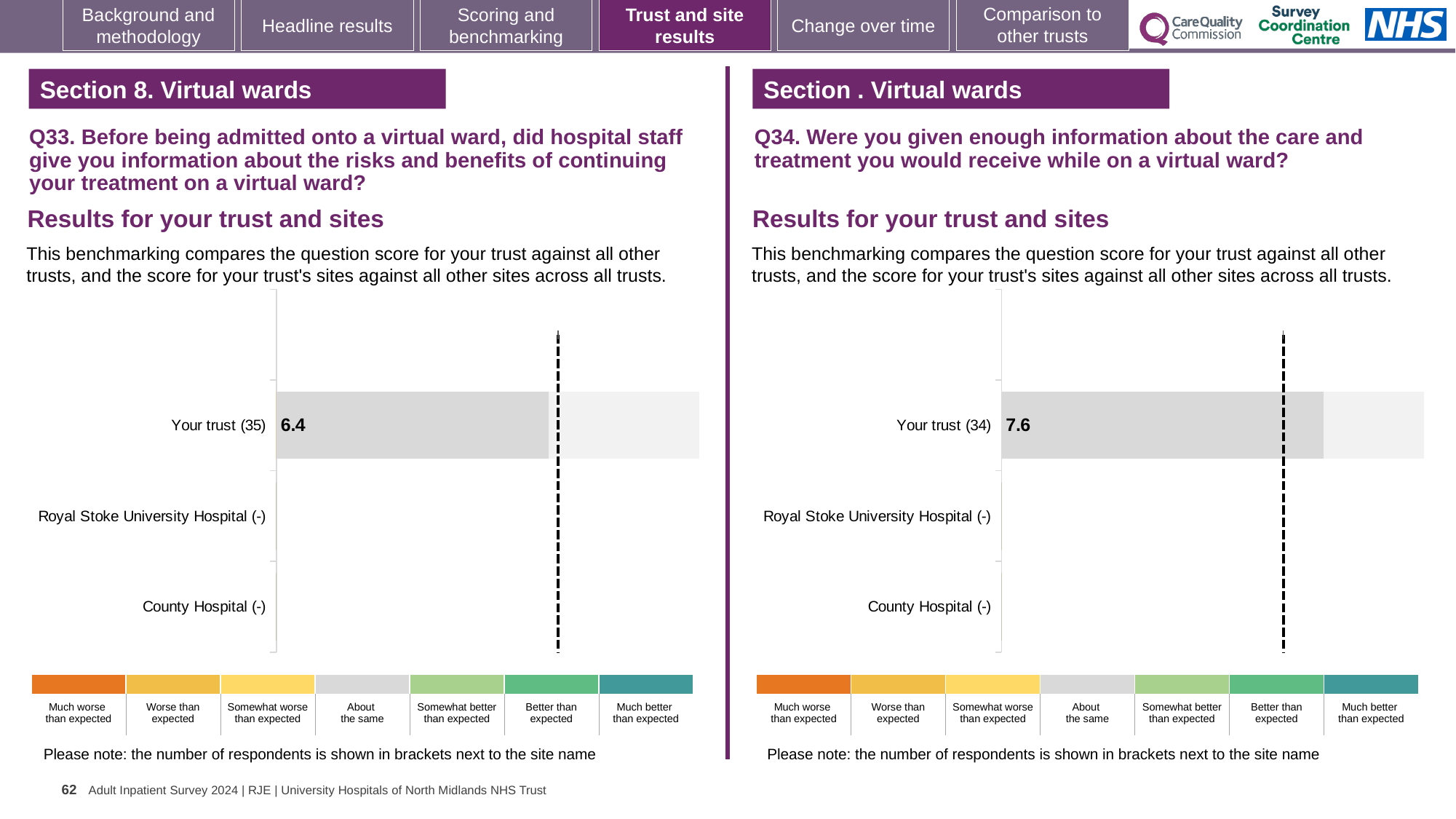
What kind of chart is used for the Q33 results on the left? Bar chart Comparing the Your trust scores, which chart shows the higher value: the Q33 chart on the left or the Q34 chart on the right? Q34 chart on the right How many categories are listed on the vertical axis of the Q33 chart on the left? 3 In the Q34 chart on the right, how many respondents are shown in brackets next to Your trust? 34 How many categories are listed on the vertical axis of the Q34 chart on the right? 3 How many benchmark bands are shown in the colour key below the Q34 chart on the right? 7 What is the difference between the Your trust score in the Q34 chart on the right and the Your trust score in the Q33 chart on the left? 1.2 In the Q33 chart on the left, what is the score for Your trust? 6.4 In the Q34 chart on the right, what is the score for Your trust? 7.6 In the Q33 chart on the left, how many respondents are shown in brackets next to Your trust? 35 In the Q33 chart on the left, which categories have no bar plotted? Royal Stoke University Hospital and County Hospital